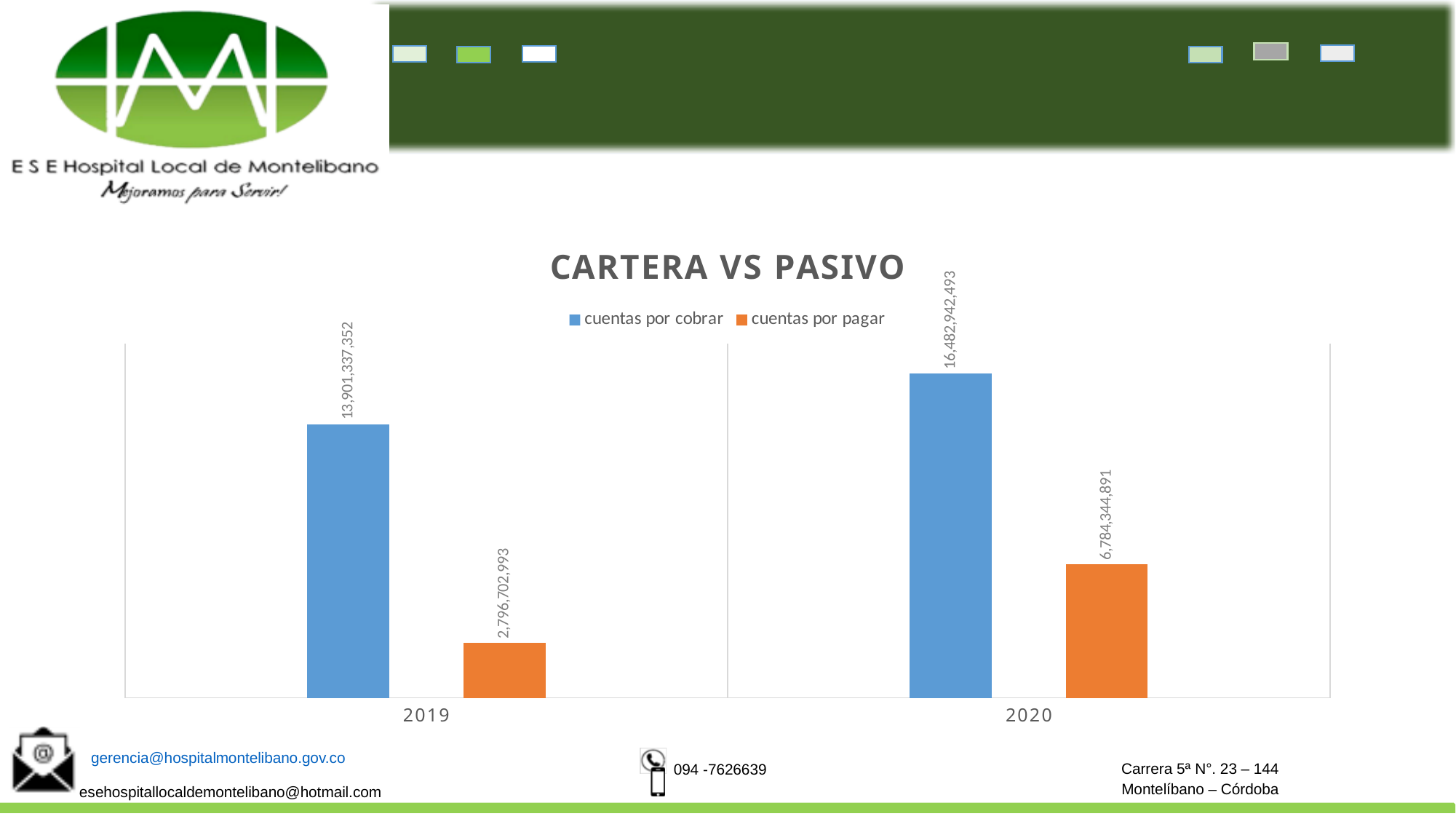
What is the difference between cuentas por cobrar and cuentas por pagar in 2019? 11,104,634,359 By how much did cuentas por pagar increase from 2019 to 2020? 3,987,641,898 What is the value of cuentas por cobrar for 2019? 13,901,337,352 What is the value of cuentas por pagar for 2020? 6,784,344,891 What type of chart is shown on the slide? bar chart Which bar on the chart has the lowest value? cuentas por pagar in 2019 What is the value of cuentas por cobrar for 2020? 16,482,942,493 What is the title of the chart? CARTERA VS PASIVO Is cuentas por cobrar in 2020 larger or smaller than cuentas por pagar in 2020? larger How many series does the legend list? 2 Which year has the higher value for cuentas por cobrar? 2020 What is the value of cuentas por pagar for 2019? 2,796,702,993